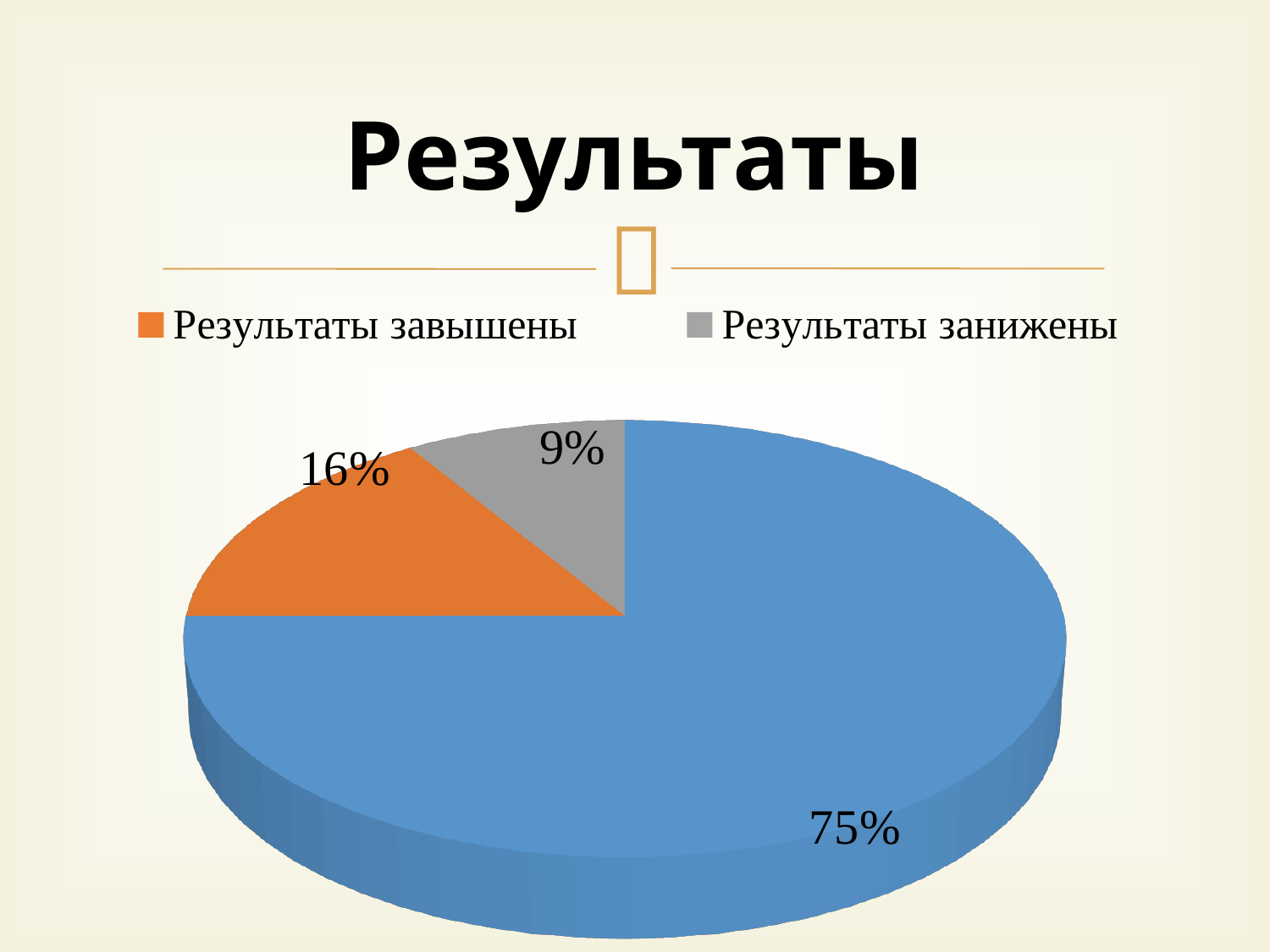
What is the value of the largest slice in the pie chart? 75% Which is larger, "Результаты завышены" or "Результаты занижены"? Результаты завышены What is the difference in percentage points between "Результаты завышены" and "Результаты занижены"? 7 percentage points What percentage is shown for "Результаты занижены"? 9% What percentage is shown for "Результаты завышены"? 16% Which legend category has the smallest slice? Результаты занижены How many slices does the pie chart have? 3 How many entries does the legend list? 2 What is the title of the chart? Результаты What percentage is shown on the blue slice of the pie? 75% What kind of chart is shown on the slide? pie chart What colour is the slice for "Результаты завышены"? orange